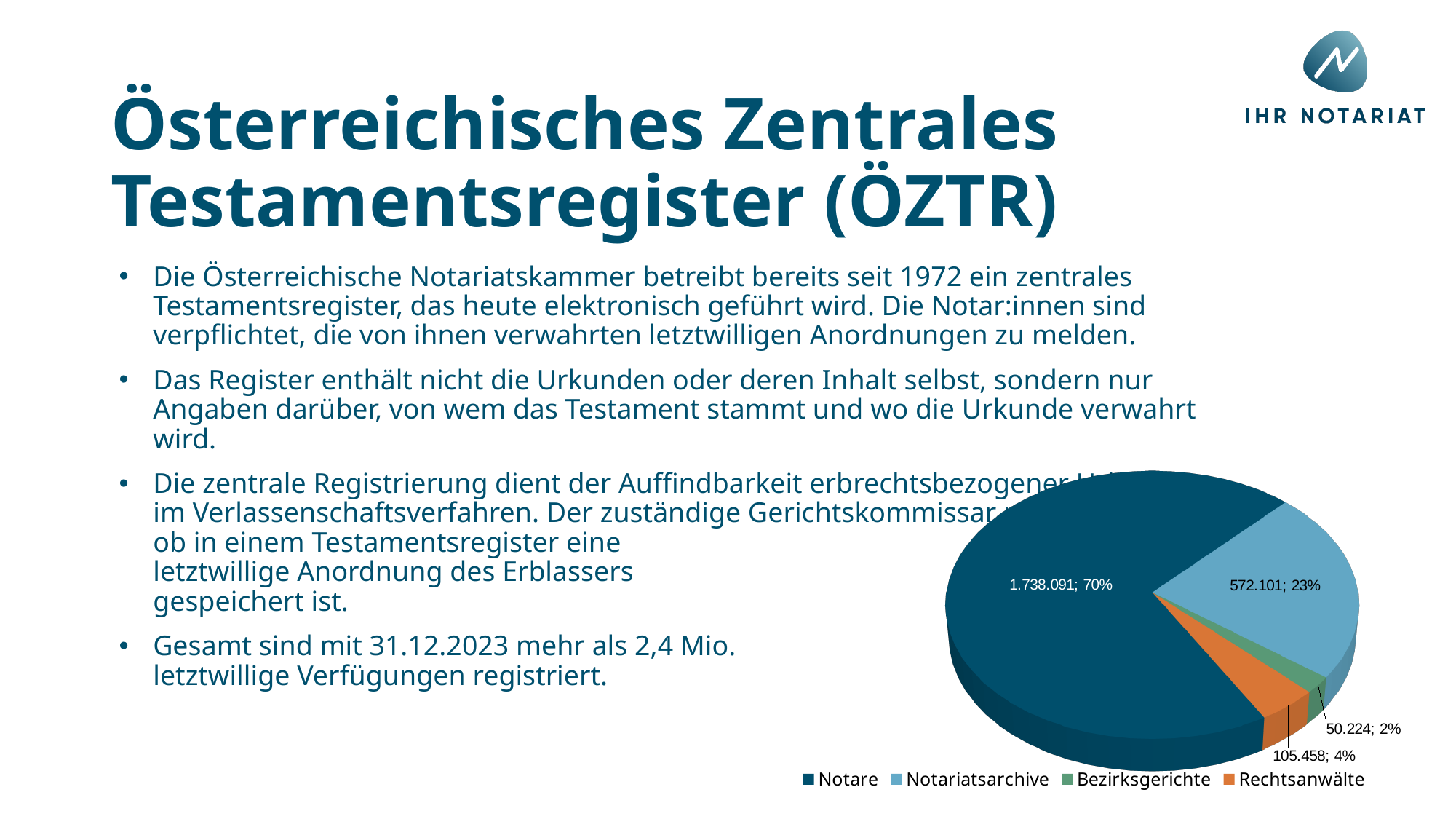
What value is shown for Rechtsanwälte in the pie chart? 105.458 Which category has the smallest slice in the pie chart? Bezirksgerichte What share of the pie does Notare account for? 70% Which is larger in the pie chart, Rechtsanwälte or Bezirksgerichte? Rechtsanwälte What kind of chart is shown on the slide? pie chart How many entries does the legend of the pie chart list? 4 Which category has the largest slice in the pie chart? Notare What value is shown for Bezirksgerichte in the pie chart? 50.224 What value is shown for Notare in the pie chart? 1.738.091 How many slices does the pie chart have? 4 What share of the pie does Notariatsarchive account for? 23% What value is shown for Notariatsarchive in the pie chart? 572.101